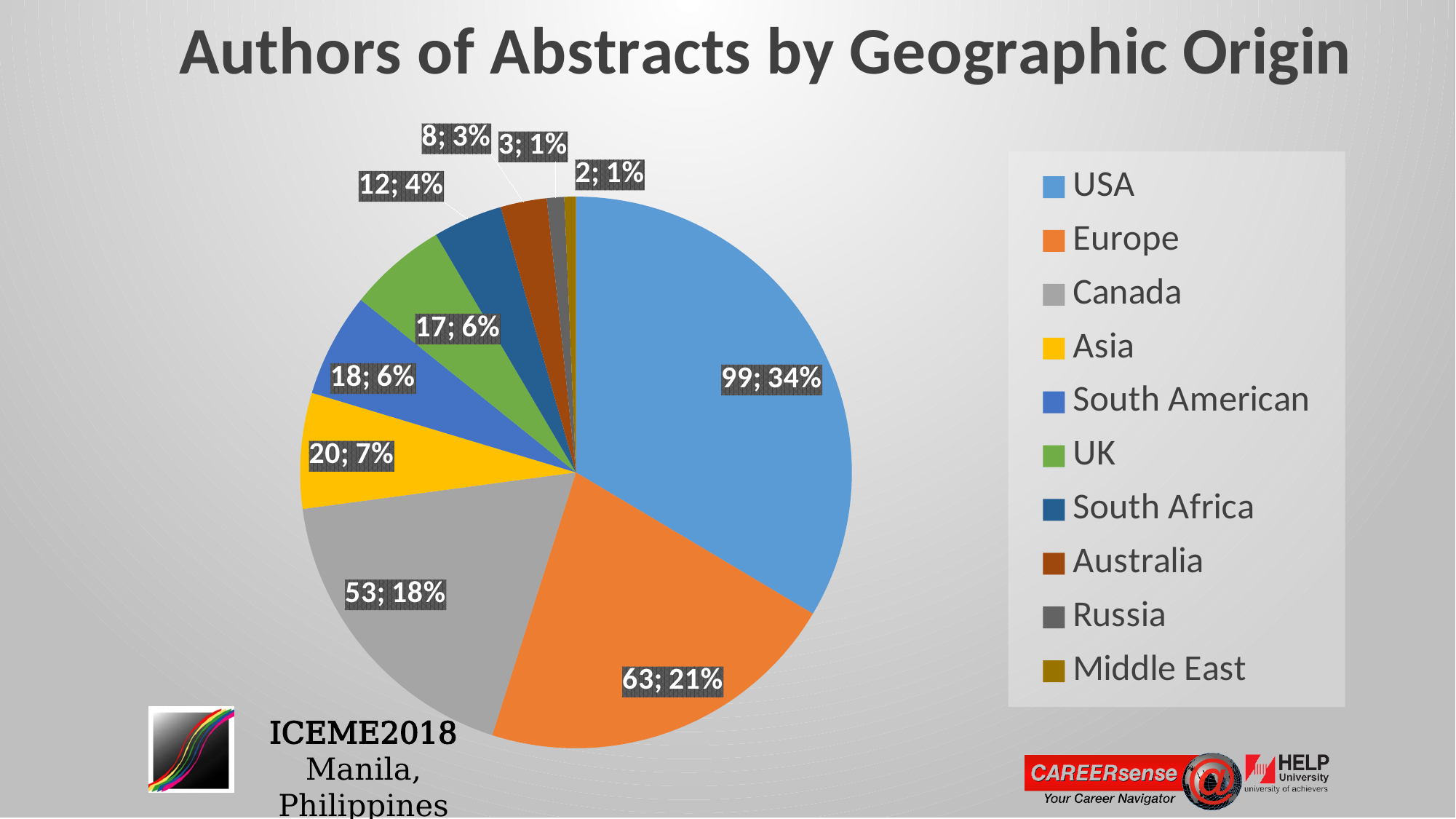
Which geographic origin has the largest slice? USA How many categories does the legend list? 10 How many authors of abstracts are from Canada? 53 Which geographic origin has the smallest slice? Middle East What colour is the slice for Asia? yellow What is the chart title? Authors of Abstracts by Geographic Origin What is the difference between the number of authors from the USA and from Europe? 36 How many authors of abstracts are from the USA? 99 What share of the pie does Europe represent? 21% What share of the pie does Australia represent? 3% What kind of chart is shown on the slide? pie chart Which has more authors, Asia or South Africa? Asia